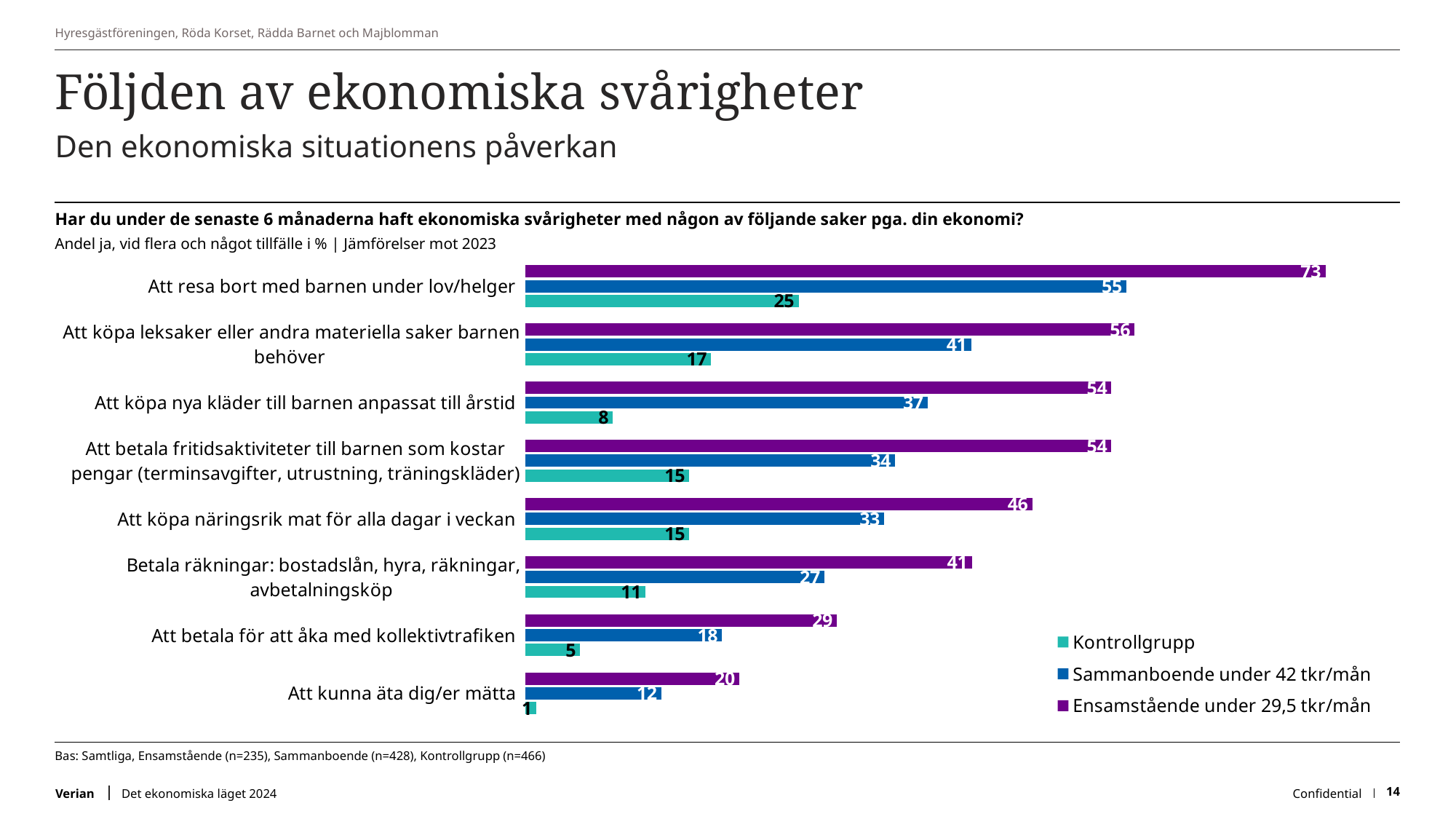
Which is larger for "Att betala för att åka med kollektivtrafiken": the Sammanboende under 42 tkr/mån value or the Kontrollgrupp value? Sammanboende under 42 tkr/mån Which category has the lowest value for Kontrollgrupp? Att kunna äta dig/er mätta What is the value for Kontrollgrupp for "Att köpa nya kläder till barnen anpassat till årstid"? 8 Which category has the highest value for Ensamstående under 29,5 tkr/mån? Att resa bort med barnen under lov/helger How many categories are shown in the chart? 8 What is the value for Ensamstående under 29,5 tkr/mån for "Att resa bort med barnen under lov/helger"? 73 How many series does the legend list? 3 What is the difference between the Ensamstående under 29,5 tkr/mån value and the Kontrollgrupp value for "Att resa bort med barnen under lov/helger"? 48 What is the difference between the Sammanboende under 42 tkr/mån value and the Kontrollgrupp value for "Betala räkningar: bostadslån, hyra, räkningar, avbetalningsköp"? 16 What is the value for Sammanboende under 42 tkr/mån for "Att köpa näringsrik mat för alla dagar i veckan"? 33 Which colour represents Kontrollgrupp in the chart? Teal (green) What kind of chart is shown on the slide? Bar chart